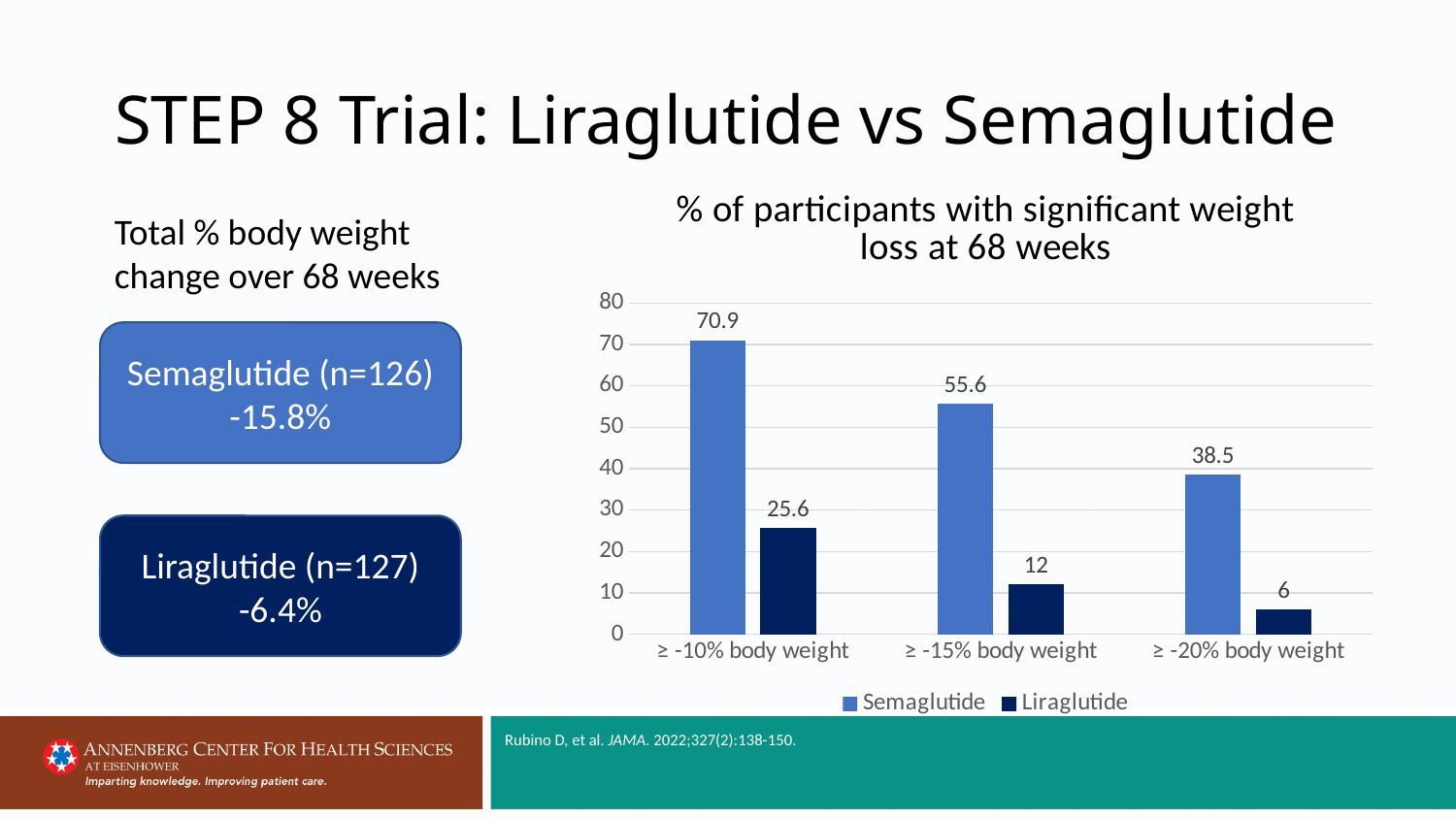
Is the value for Liraglutide in the ≥ -10% body weight category greater or less than 30? less How many categories are shown on the x axis of the chart? 3 Which category has the lowest value for Liraglutide? ≥ -20% body weight What is the value for Liraglutide in the ≥ -20% body weight category? 6 What is the value for Liraglutide in the ≥ -15% body weight category? 12 What kind of chart is shown on the slide? bar chart Which category has the highest value for Semaglutide? ≥ -10% body weight How many series does the chart legend list? 2 What percentage of Semaglutide participants achieved ≥ -10% body weight loss at 68 weeks? 70.9 Which series has the larger value in the ≥ -20% body weight category, Semaglutide or Liraglutide? Semaglutide What is the difference between Semaglutide and Liraglutide in the ≥ -15% body weight category? 43.6 Do the Semaglutide values rise or fall moving from ≥ -10% to ≥ -20% body weight along the x axis? fall